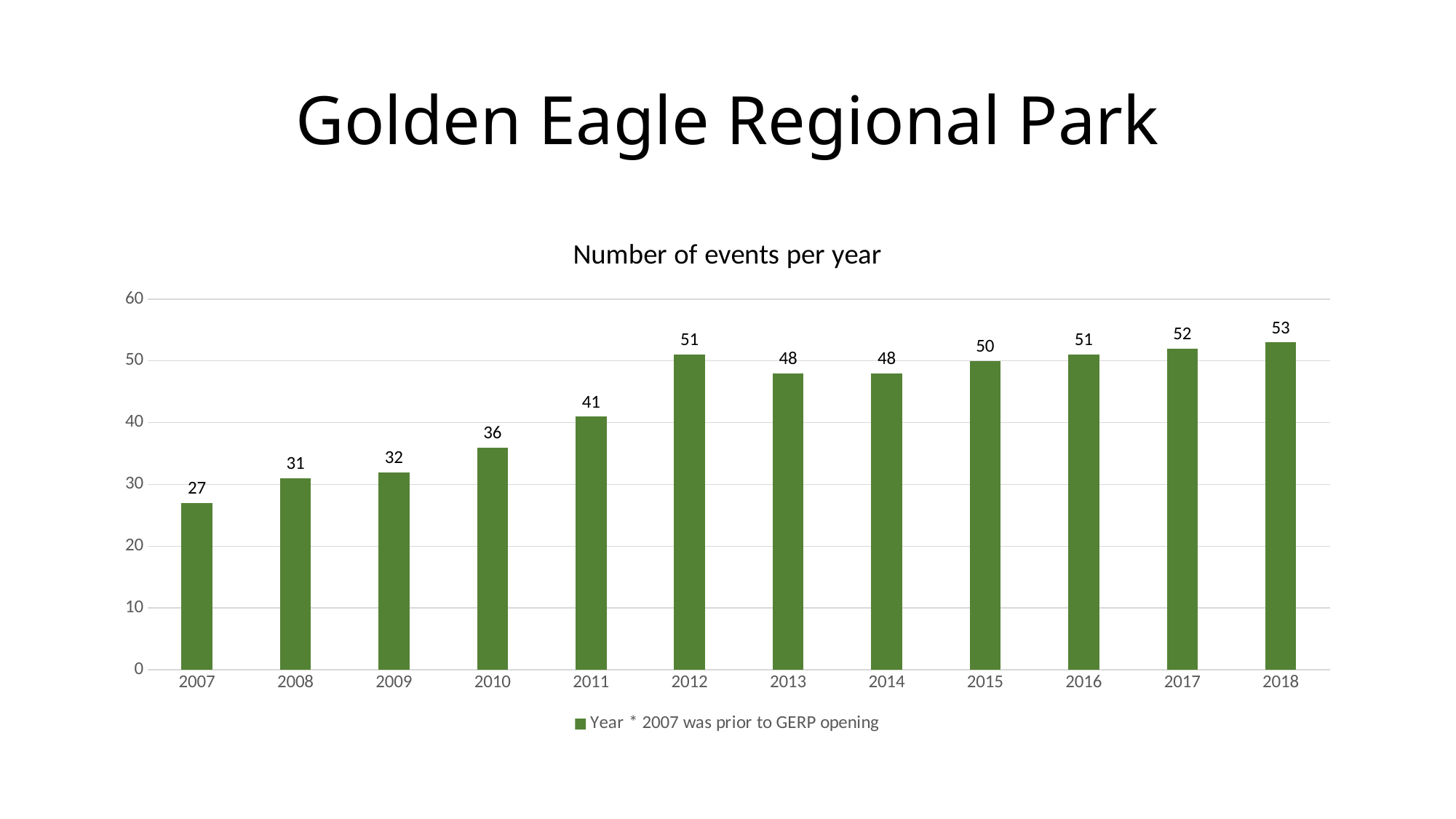
Which year had more events, 2010 or 2013? 2013 How many years are shown on the x axis? 12 Which year has the highest number of events? 2018 What is the title of the chart? Number of events per year What is the number of events in 2015? 50 What is the difference in the number of events between 2012 and 2011? 10 What is the difference in the number of events between 2018 and 2007? 26 Which year has the lowest number of events? 2007 What kind of chart is shown on the slide? Bar chart What is the number of events in 2012? 51 Do the number of events generally rise or fall from 2007 to 2012? Rise What is the number of events in 2007? 27